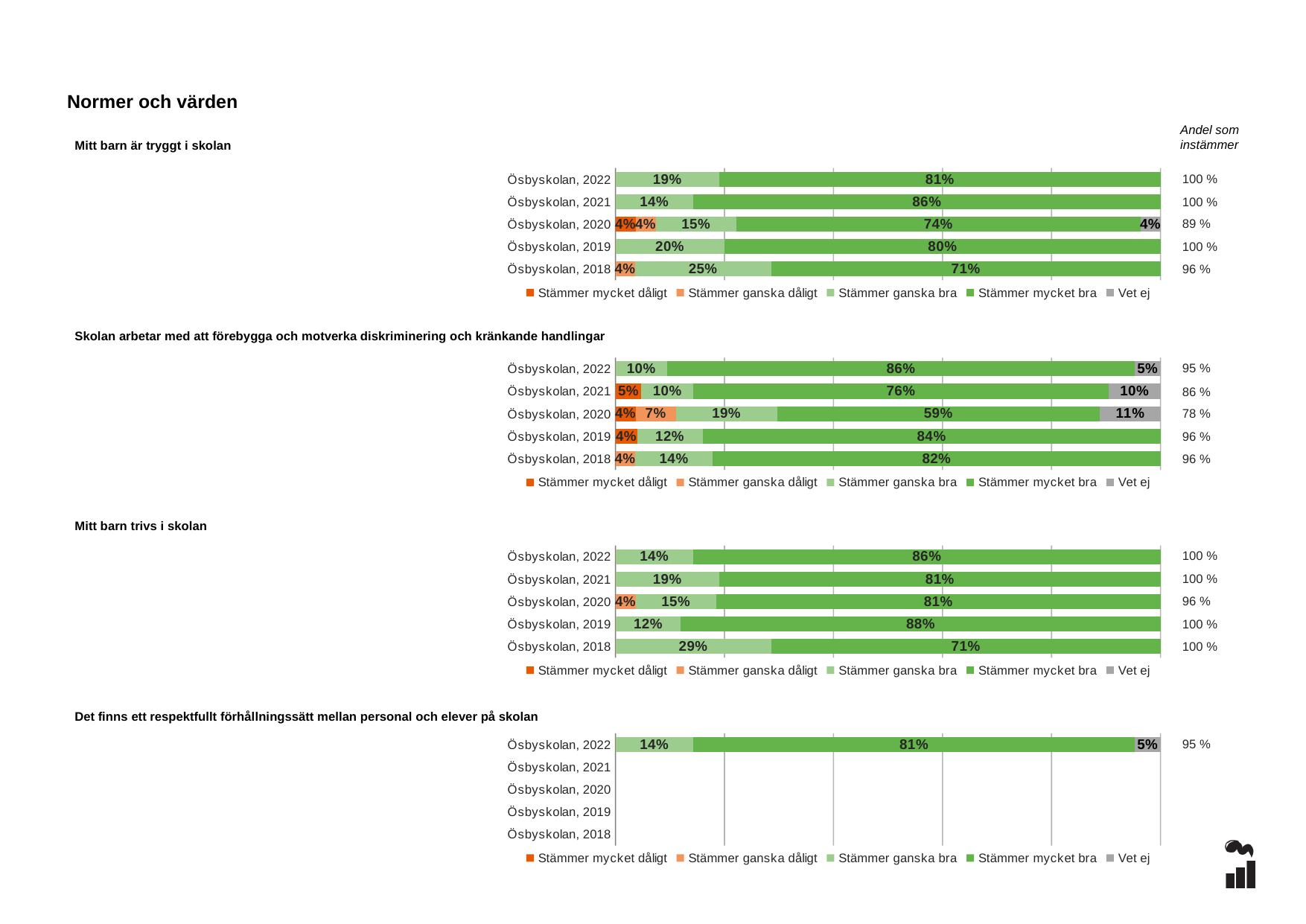
In the chart 'Det finns ett respektfullt förhållningssätt mellan personal och elever på skolan', what is the 'Stämmer mycket bra' value for Ösbyskolan, 2022? 81% In the chart 'Mitt barn är tryggt i skolan', what is the difference between the 'Stämmer mycket bra' values for Ösbyskolan, 2021 and Ösbyskolan, 2018? 15% How many year categories are shown on the y axis of the chart 'Mitt barn är tryggt i skolan'? 5 In the chart 'Skolan arbetar med att förebygga och motverka diskriminering och kränkande handlingar', what is the 'Vet ej' value for Ösbyskolan, 2020? 11% In the chart 'Skolan arbetar med att förebygga och motverka diskriminering och kränkande handlingar', is the 'Stämmer mycket bra' value larger for Ösbyskolan, 2022 or Ösbyskolan, 2021? Ösbyskolan, 2022 In the chart 'Mitt barn är tryggt i skolan', what is the value of 'Stämmer mycket bra' for Ösbyskolan, 2021? 86% In the chart 'Mitt barn trivs i skolan', which year has the highest 'Stämmer mycket bra' value? Ösbyskolan, 2019 What kind of chart is 'Mitt barn trivs i skolan'? Stacked bar chart In the chart 'Mitt barn trivs i skolan', what is the 'Stämmer ganska bra' value for Ösbyskolan, 2018? 29% In the chart 'Skolan arbetar med att förebygga och motverka diskriminering och kränkande handlingar', which year has the lowest 'Stämmer mycket bra' value? Ösbyskolan, 2020 In the chart 'Mitt barn är tryggt i skolan', which year has the highest 'Stämmer ganska bra' value? Ösbyskolan, 2018 How many series does the legend list in the chart 'Mitt barn trivs i skolan'? 5